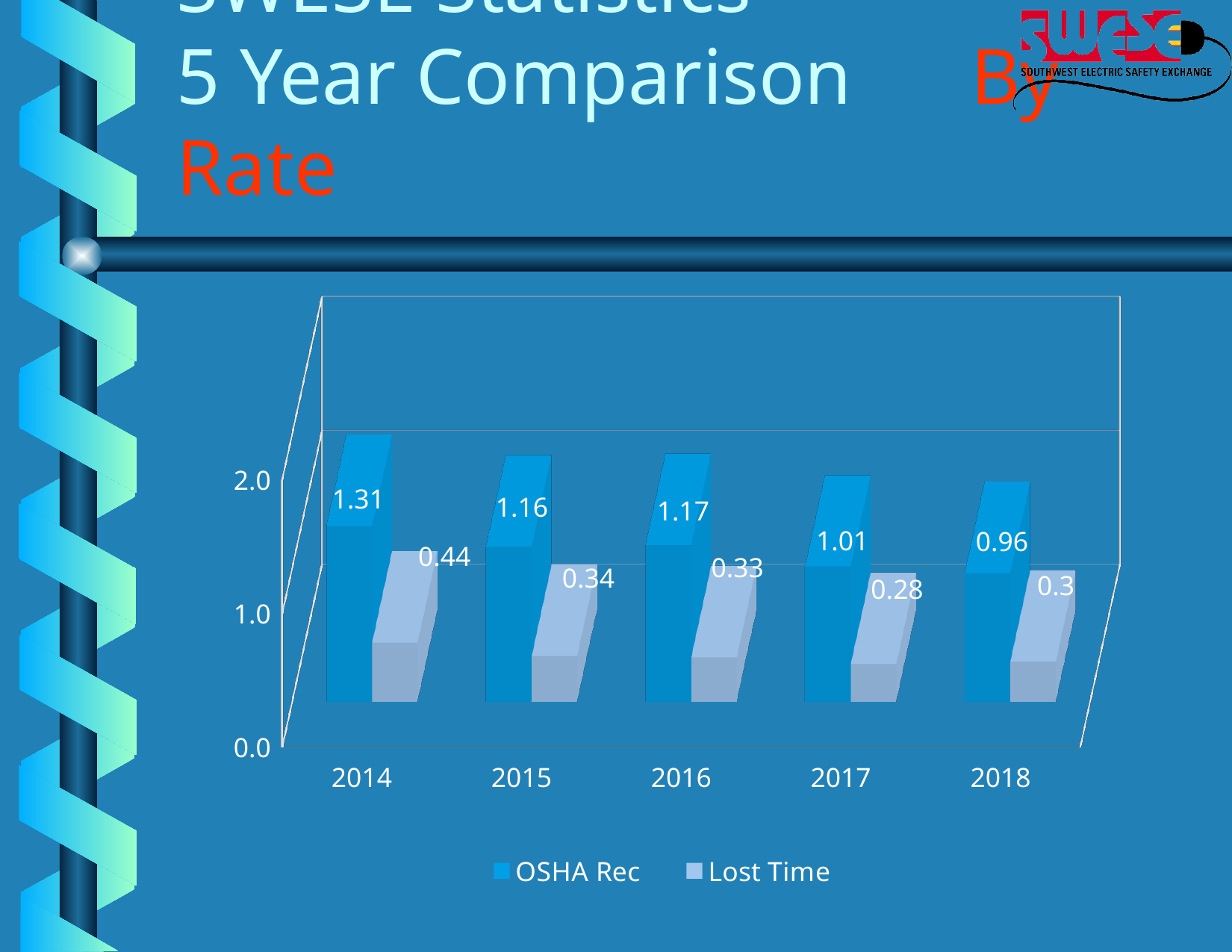
What is the OSHA Rec value for 2014? 1.31 How many series does the legend list? 2 What is the Lost Time value for 2018? 0.3 What is the Lost Time value for 2017? 0.28 Which year has the lowest OSHA Rec value? 2018 Is the OSHA Rec value for 2015 greater or less than 1.0? greater How many years are shown on the x axis? 5 Which year has the highest OSHA Rec value? 2014 Which is larger, the Lost Time value for 2014 or for 2016? 2014 What kind of chart is shown on the slide? bar chart What is the difference between the OSHA Rec values for 2014 and 2018? 0.35 Which year has the lowest Lost Time value? 2017